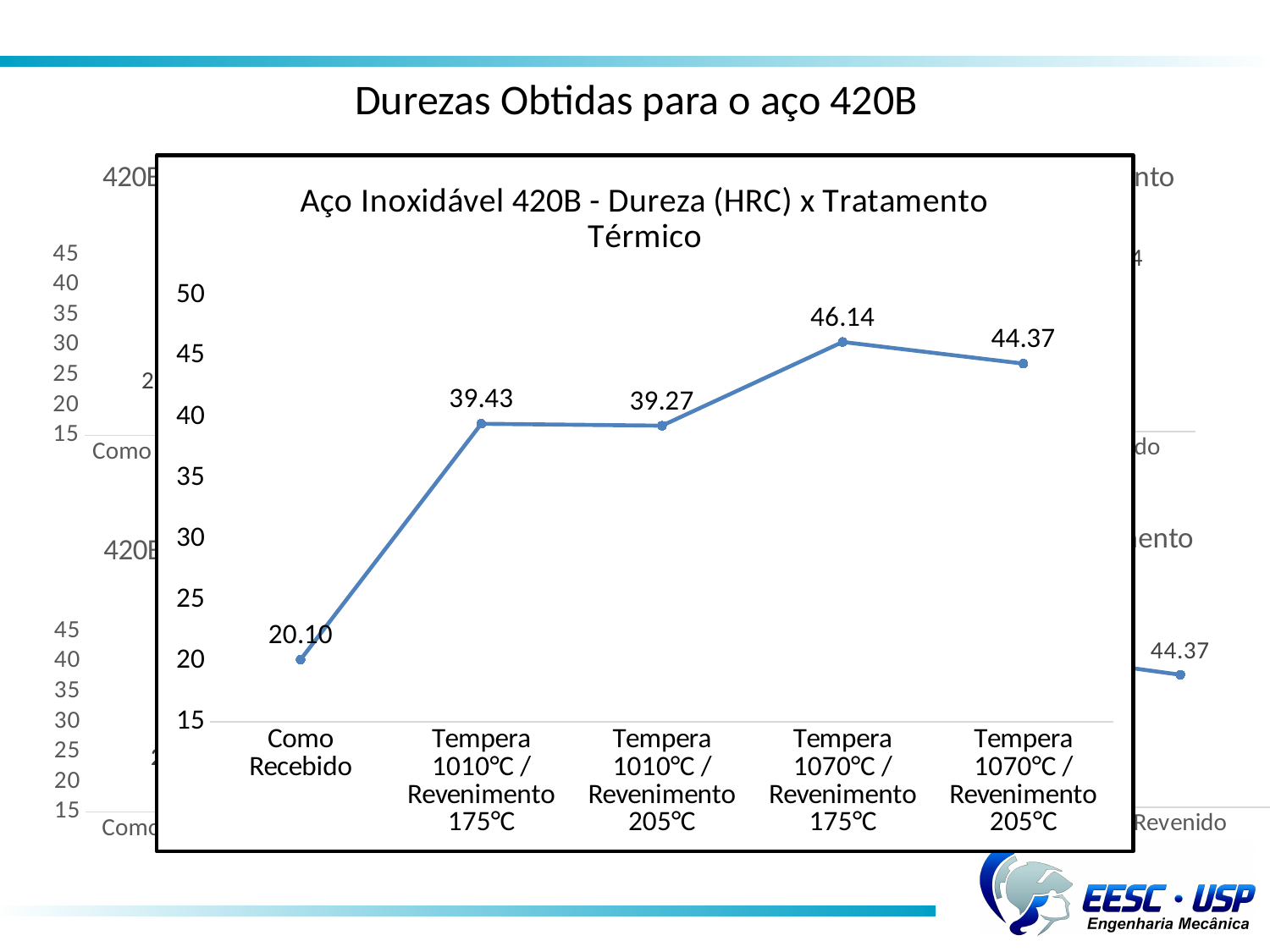
In the chart titled "Aço Inoxidável 420B - Dureza (HRC) x Tratamento Térmico", how many treatment conditions are plotted? 5 In the chart titled "Aço Inoxidável 420B - Dureza (HRC) x Tratamento Térmico", what is the value for "Tempera 1010°C / Revenimento 175°C"? 39.43 In the chart titled "Aço Inoxidável 420B - Dureza (HRC) x Tratamento Térmico", which condition has the lowest hardness? Como Recebido In the chart titled "Aço Inoxidável 420B - Dureza (HRC) x Tratamento Térmico", is the value for "Tempera 1070°C / Revenimento 175°C" greater or less than 45? greater What is the title of the slide? Durezas Obtidas para o aço 420B In the chart titled "Aço Inoxidável 420B - Dureza (HRC) x Tratamento Térmico", what is the difference between the values for "Tempera 1070°C / Revenimento 175°C" and "Como Recebido"? 26.04 In the chart titled "Aço Inoxidável 420B - Dureza (HRC) x Tratamento Térmico", what is the difference between the values for "Tempera 1070°C / Revenimento 175°C" and "Tempera 1070°C / Revenimento 205°C"? 1.77 In the chart titled "Aço Inoxidável 420B - Dureza (HRC) x Tratamento Térmico", what is the value for "Tempera 1070°C / Revenimento 205°C"? 44.37 In the chart titled "Aço Inoxidável 420B - Dureza (HRC) x Tratamento Térmico", which is larger: the value for "Tempera 1010°C / Revenimento 175°C" or "Tempera 1010°C / Revenimento 205°C"? Tempera 1010°C / Revenimento 175°C In the chart titled "Aço Inoxidável 420B - Dureza (HRC) x Tratamento Térmico", which treatment has the highest hardness? Tempera 1070°C / Revenimento 175°C What kind of chart is the one titled "Aço Inoxidável 420B - Dureza (HRC) x Tratamento Térmico"? Line chart In the chart titled "Aço Inoxidável 420B - Dureza (HRC) x Tratamento Térmico", what is the hardness value for "Como Recebido"? 20.10